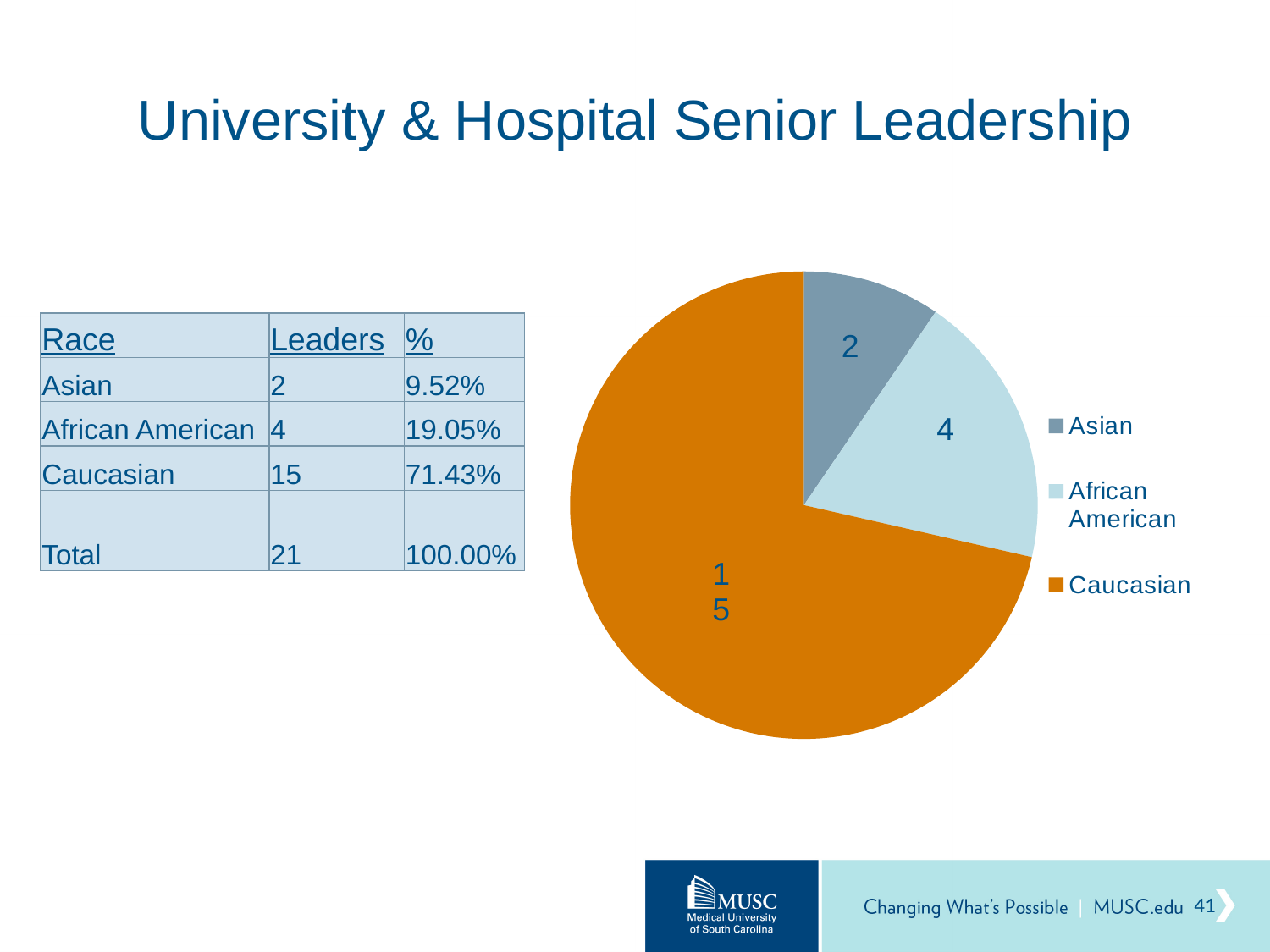
What is the difference between the Caucasian and African American values in the pie chart? 11 What is the total of all slices in the pie chart? 21 Which is larger in the pie chart, the African American slice or the Asian slice? African American How many slices does the pie chart have? 3 How many entries does the legend of the pie chart list? 3 What is the value shown for the Caucasian slice of the pie chart? 15 Which category has the largest slice in the pie chart? Caucasian What colour is the Caucasian slice in the pie chart? orange What is the value shown for the African American slice of the pie chart? 4 Which category has the smallest slice in the pie chart? Asian What kind of chart is shown on the slide? pie chart What is the value shown for the Asian slice of the pie chart? 2